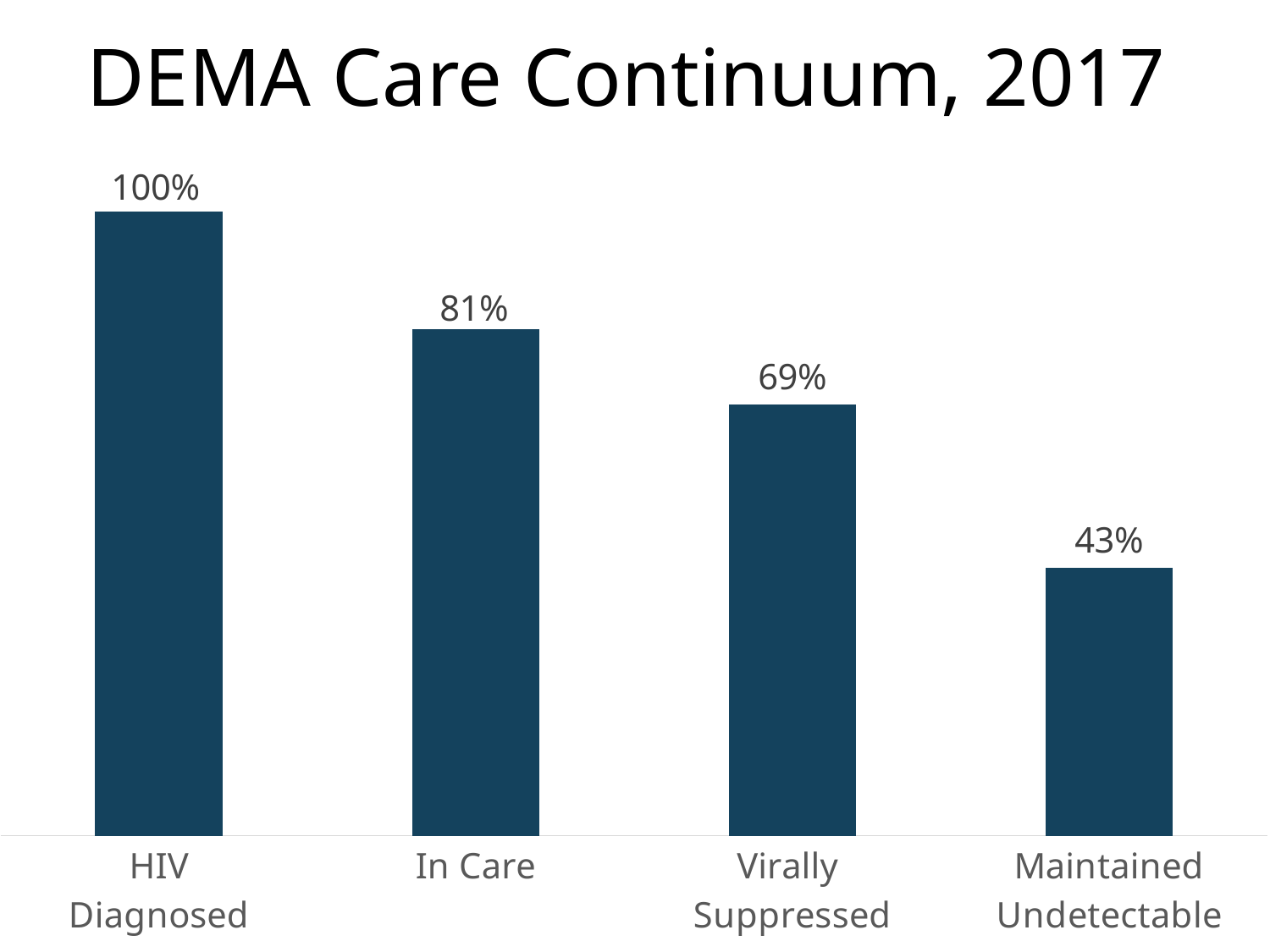
What is the value for HIV Diagnosed? 100% What is the difference between the values for In Care and Virally Suppressed? 12% What is the value for Virally Suppressed? 69% Which is larger, the value for In Care or the value for Maintained Undetectable? In Care Do the values rise or fall from left to right along the x axis? Fall What is the difference between the values for Virally Suppressed and Maintained Undetectable? 26% What is the value for Maintained Undetectable? 43% Which category has the lowest value? Maintained Undetectable What is the value for In Care? 81% What kind of chart is shown on the slide? Bar chart Which category has the highest value? HIV Diagnosed How many categories are shown in the chart? 4